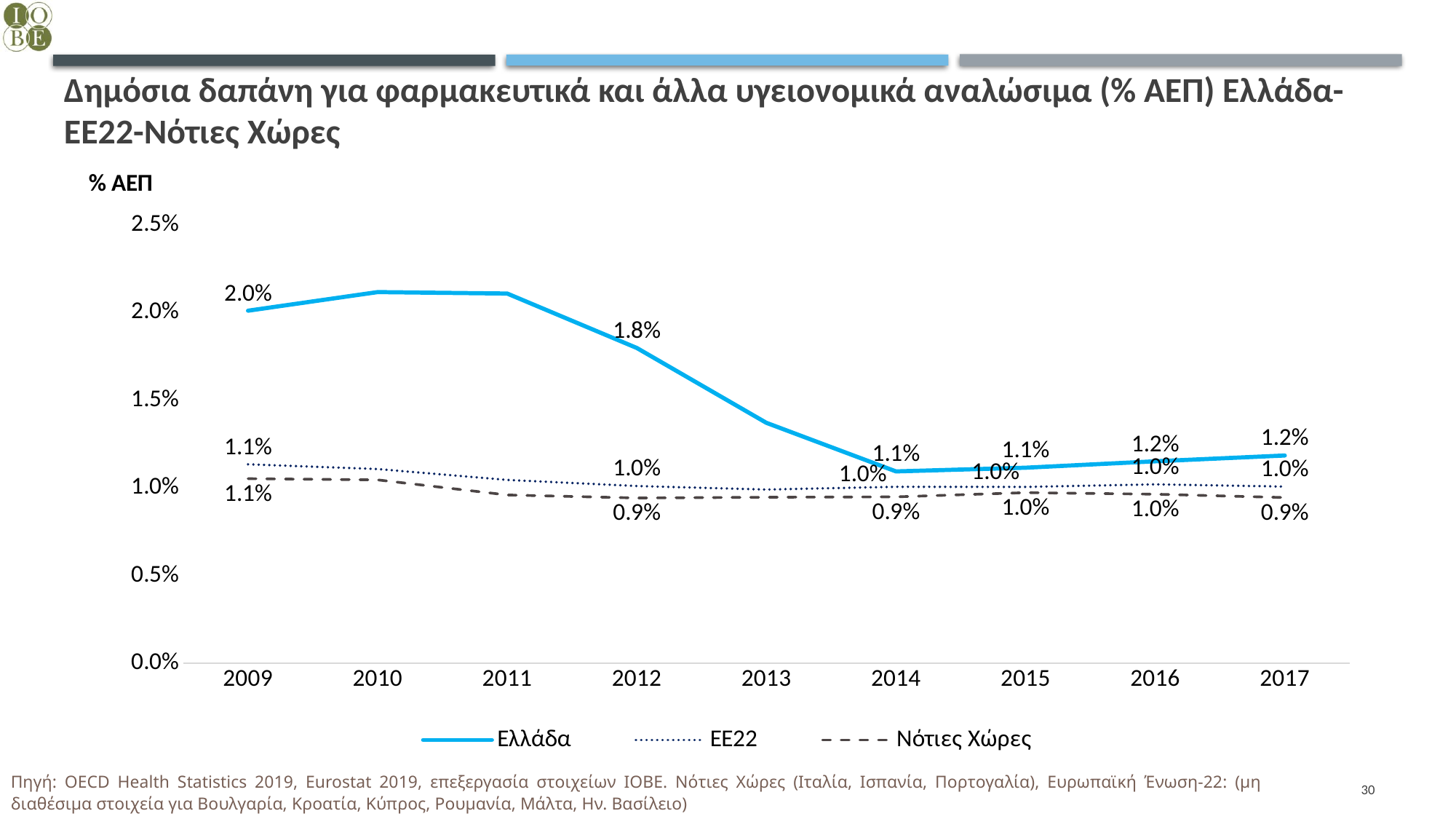
What is the difference between the Ελλάδα and ΕΕ22 values in 2009? 0.9 percentage points How many series does the legend list? 3 Is the value for Ελλάδα in 2013 greater or less than 1.5%? less Does the value for Ελλάδα rise or fall between 2011 and 2014? fall What is the value for ΕΕ22 in 2017? 1.0% What is the value for Ελλάδα in 2012? 1.8% What is the value for Ελλάδα in 2009? 2.0% In 2017, which is larger: the value for Ελλάδα or the value for Νότιες Χώρες? Ελλάδα What kind of chart is shown on the slide? line chart Which series has the highest value in 2009? Ελλάδα What is the value for Νότιες Χώρες in 2017? 0.9% How many years are shown on the x axis? 9